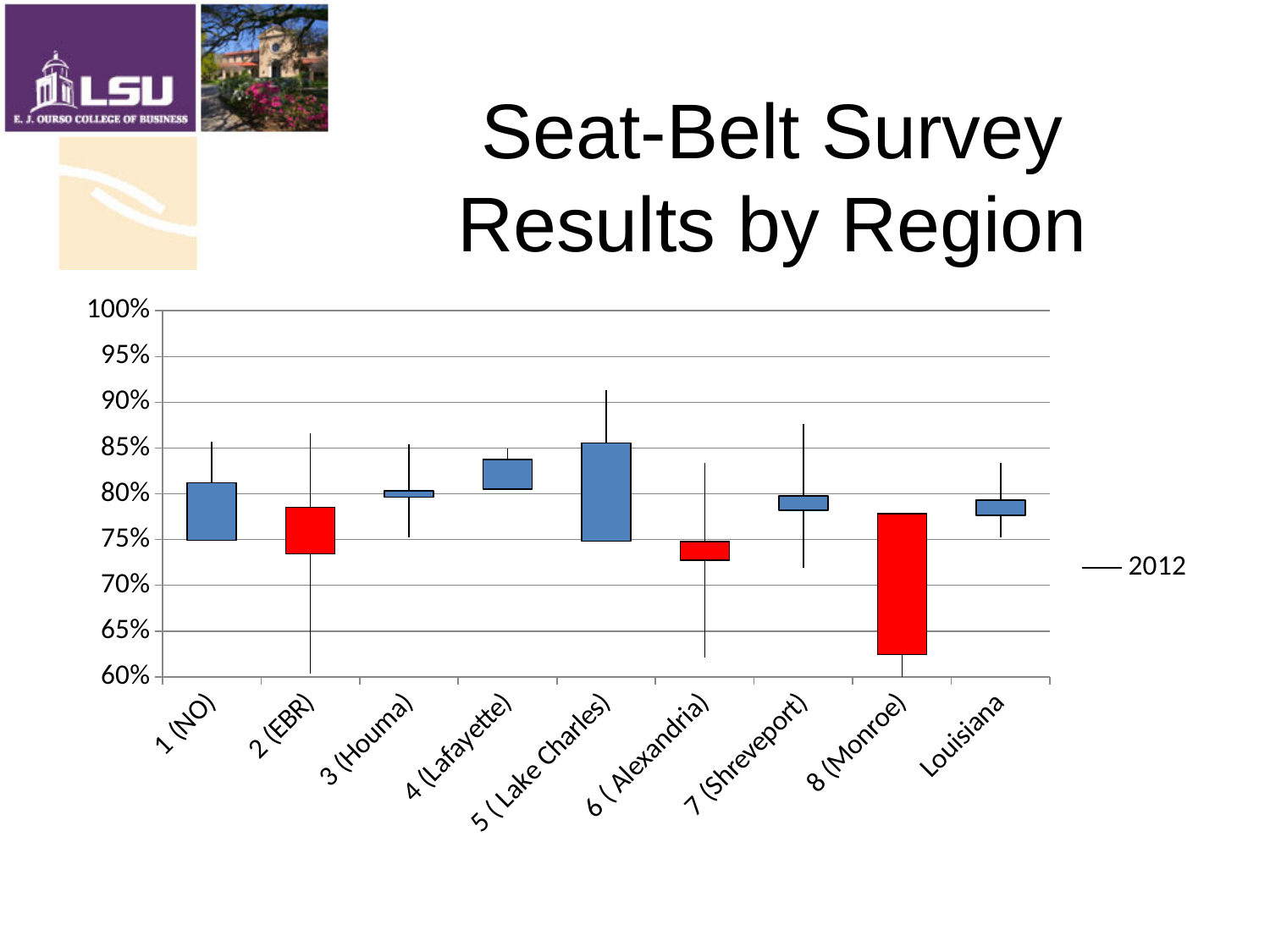
How many regions are shown along the x axis of the chart? 9 How many of the boxes in the chart are coloured red? 3 Which region's box extends the lowest on the chart? 8 (Monroe) What is the only entry in the chart legend? 2012 Is the top of the box for 1 (NO) greater or less than 80%? greater Is the top of the box for 8 (Monroe) greater or less than 80%? less Is the bottom of the box for 8 (Monroe) greater or less than 65%? less Which region has the taller box, 8 (Monroe) or 3 (Houma)? 8 (Monroe) How many series does the chart legend list? 1 Which region has the highest upper whisker on the chart? 5 ( Lake Charles) What kind of chart is shown on the slide? stock (candlestick) chart